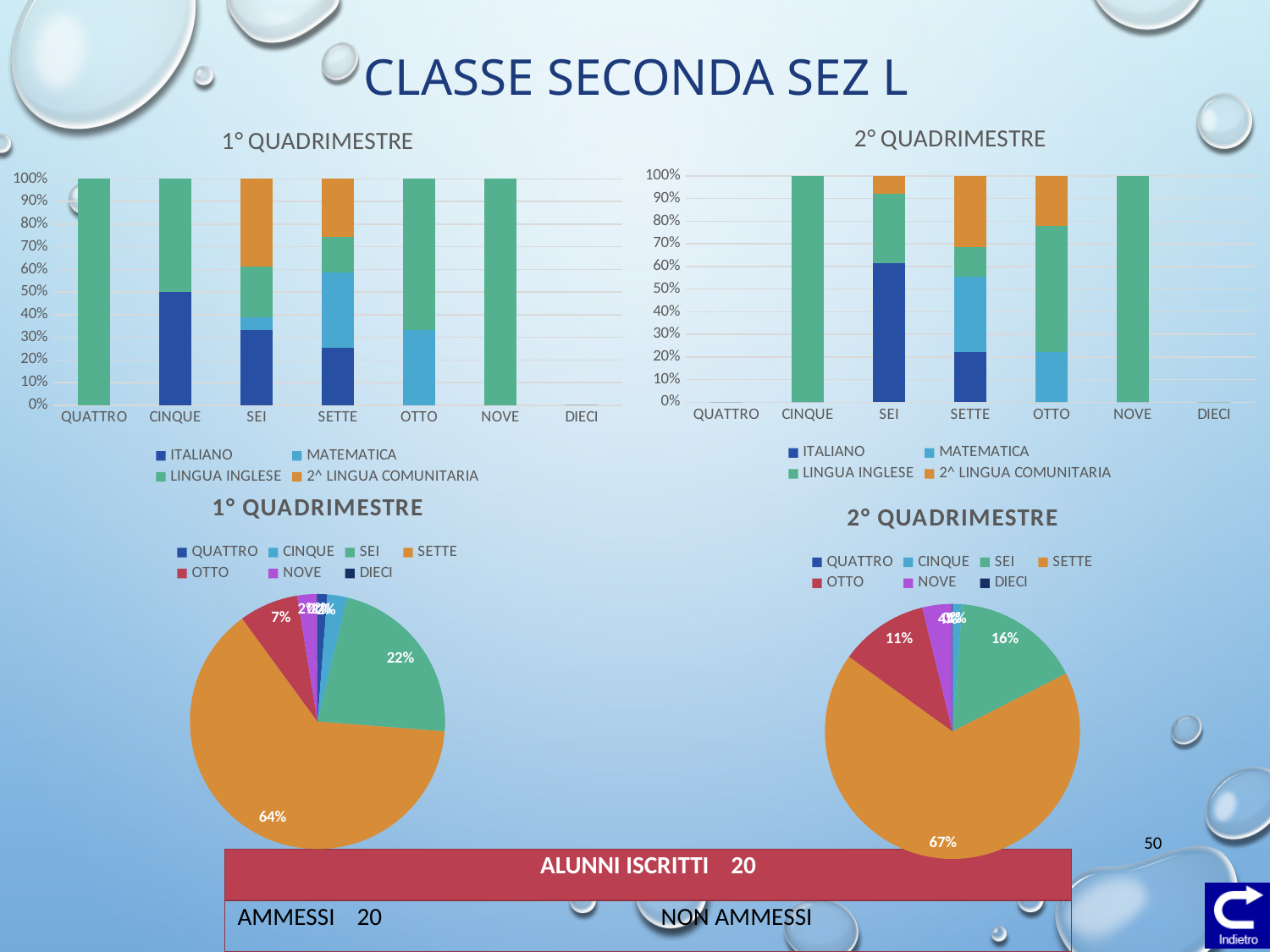
In the bottom-left '1° QUADRIMESTRE' pie chart, what share does SEI have? 22% In the bottom-right '2° QUADRIMESTRE' pie chart, what share does OTTO have? 11% In the top-left '1° QUADRIMESTRE' bar chart, how many series does the legend list? 4 In the bottom-right '2° QUADRIMESTRE' pie chart, which category has the largest slice? SETTE In the bottom-left '1° QUADRIMESTRE' pie chart, what is the difference in percentage points between the SETTE and SEI slices? 42 In the bottom-left '1° QUADRIMESTRE' pie chart, what share does SETTE have? 64% In the bottom-right '2° QUADRIMESTRE' pie chart, which slice is larger, SEI or OTTO? SEI In the top-right '2° QUADRIMESTRE' bar chart, is the ITALIANO portion for SEI greater or less than 50%? greater What kind of chart is the top-left '1° QUADRIMESTRE' chart? stacked bar chart In the top-right '2° QUADRIMESTRE' bar chart, how many categories are shown on the x axis? 7